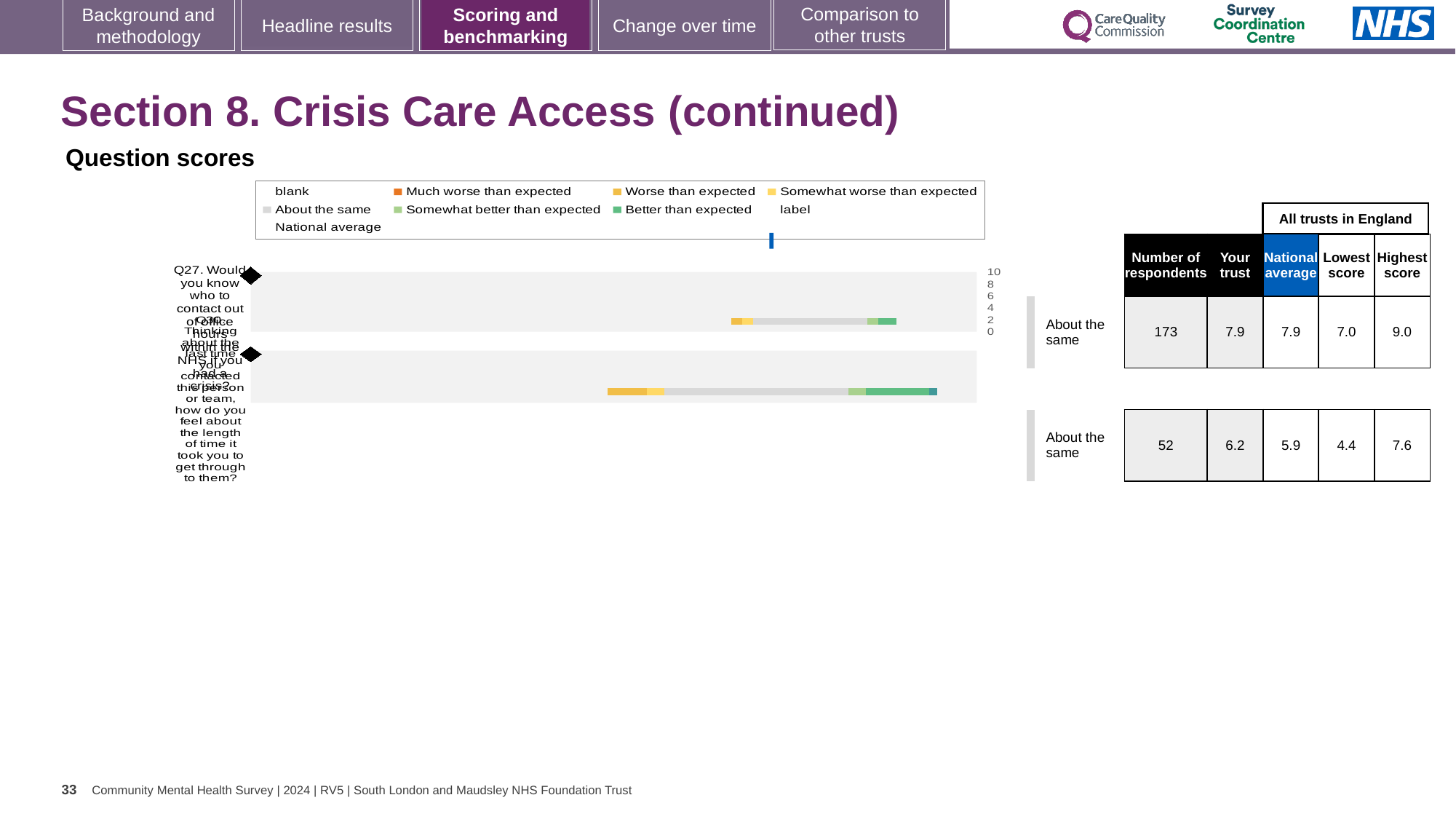
What kind of chart is used to show the question scores on this slide? bar chart What benchmark category is shown for both Q27 and Q30 in the chart? About the same What is the highest score among all trusts in England for Q27? 9.0 What is the 'Your trust' score for Q30 (how do you feel about the length of time it took to get through)? 6.2 How many questions are plotted in the question scores chart? 2 What is the national average score for Q30? 5.9 How many respondents answered Q30? 52 What is the lowest score among all trusts in England for Q30? 4.4 How many respondents answered Q27? 173 What is the difference between the 'Your trust' score and the national average for Q30? 0.3 What is the 'Your trust' score for Q27 (would you know who to contact out of office hours)? 7.9 Which question has the higher 'Your trust' score, Q27 or Q30? Q27